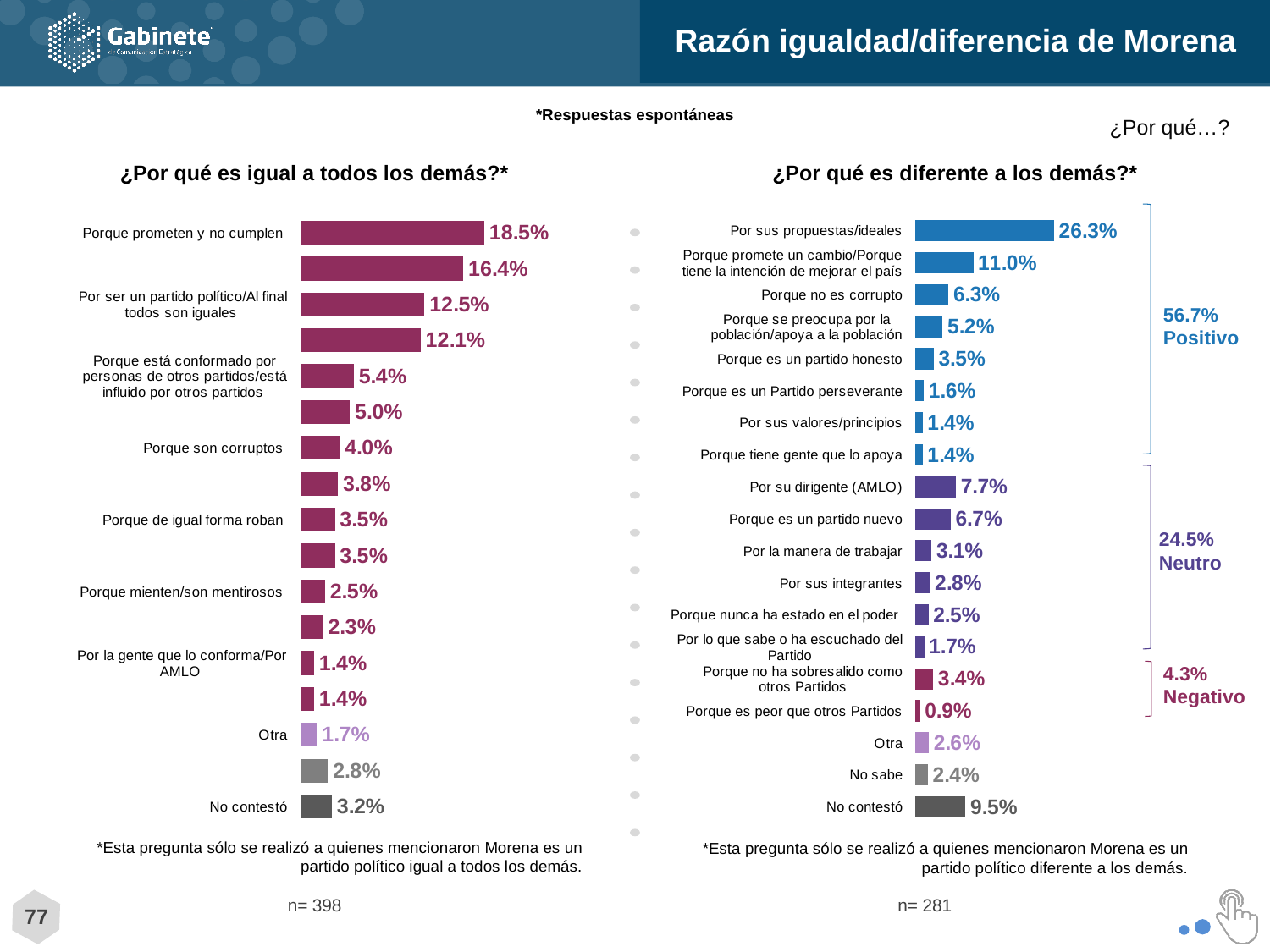
In the chart '¿Por qué es diferente a los demás?*', what share is labelled as 'Positivo'? 56.7% In the chart '¿Por qué es diferente a los demás?*', which category has the lowest value? Porque es peor que otros Partidos In the chart '¿Por qué es igual a todos los demás?*', what is the value for 'Porque prometen y no cumplen'? 18.5% In the chart '¿Por qué es diferente a los demás?*', how many categories are shown? 19 In the chart '¿Por qué es diferente a los demás?*', what is the value for 'Por su dirigente (AMLO)'? 7.7% In the chart '¿Por qué es diferente a los demás?*', what is the difference between 'Por sus propuestas/ideales' and 'Porque promete un cambio/Porque tiene la intención de mejorar el país'? 15.3% What kind of chart is '¿Por qué es diferente a los demás?*'? Bar chart In the chart '¿Por qué es diferente a los demás?*', which category has the highest value? Por sus propuestas/ideales In the chart '¿Por qué es igual a todos los demás?*', what is the value for 'No contestó'? 3.2% In the chart '¿Por qué es diferente a los demás?*', what is the value for 'Por sus propuestas/ideales'? 26.3% In the chart '¿Por qué es igual a todos los demás?*', what is the value for 'Porque son corruptos'? 4.0% In the chart '¿Por qué es igual a todos los demás?*', which is larger: 'Porque son corruptos' or 'Porque mienten/son mentirosos'? Porque son corruptos